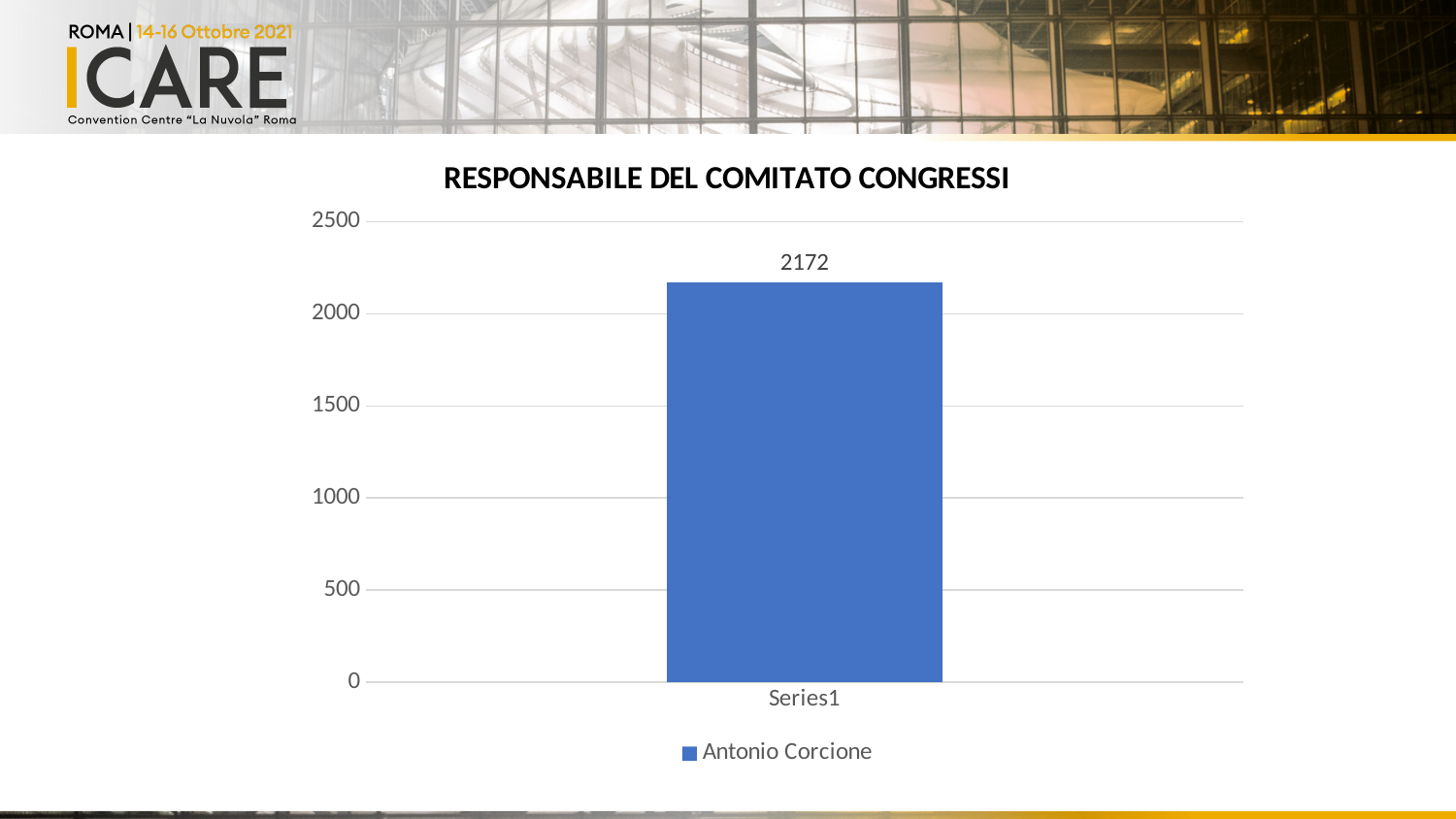
Is the value for Antonio Corcione greater or less than 2500? less Is the value for Antonio Corcione greater or less than 2000? greater What is the value shown for Antonio Corcione in the chart? 2172 What is the title of the chart? RESPONSABILE DEL COMITATO CONGRESSI What name appears in the chart legend? Antonio Corcione How many bars are plotted in the chart? 1 What kind of chart is shown on the slide? bar chart How many series does the legend list? 1 What is the highest value shown on the y axis? 2500 What is the category label shown on the x axis? Series1